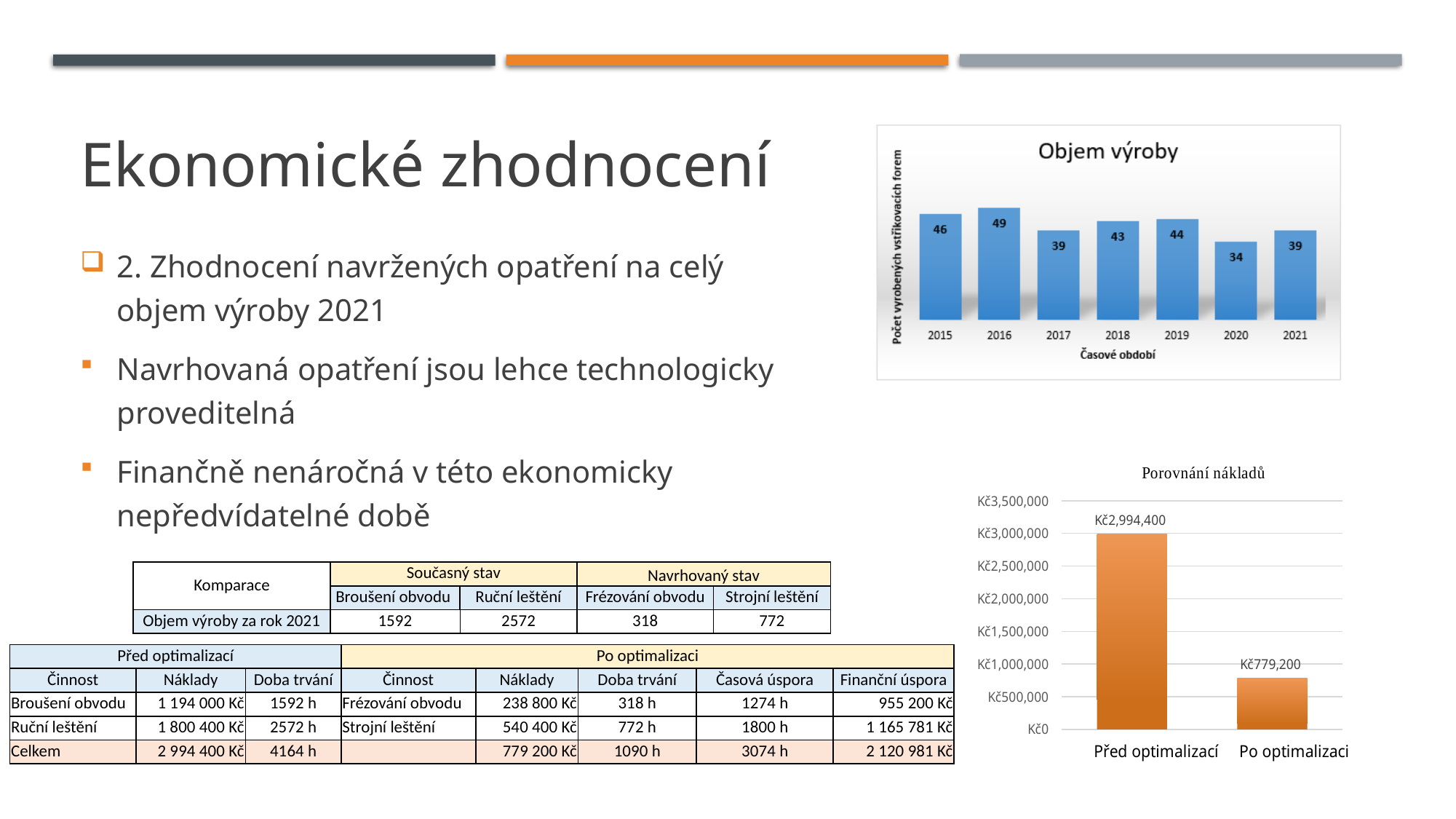
In the 'Objem výroby' chart, what is the value for 2016? 49 What type of chart is the 'Objem výroby' chart? bar chart In the 'Porovnání nákladů' chart, what is the value for 'Po optimalizaci'? Kč779,200 In the 'Objem výroby' chart, which year has the highest value? 2016 What is the x-axis title of the 'Objem výroby' chart? Časové období In the 'Porovnání nákladů' chart, what is the value for 'Před optimalizací'? Kč2,994,400 In the 'Objem výroby' chart, which is larger, the value for 2018 or the value for 2019? 2019 In the 'Porovnání nákladů' chart, what is the difference between 'Před optimalizací' and 'Po optimalizaci'? Kč2,215,200 In the 'Objem výroby' chart, what is the value for 2020? 34 In the 'Objem výroby' chart, what is the difference between the values for 2015 and 2017? 7 In the 'Objem výroby' chart, which year has the lowest value? 2020 How many years are shown in the 'Objem výroby' chart? 7